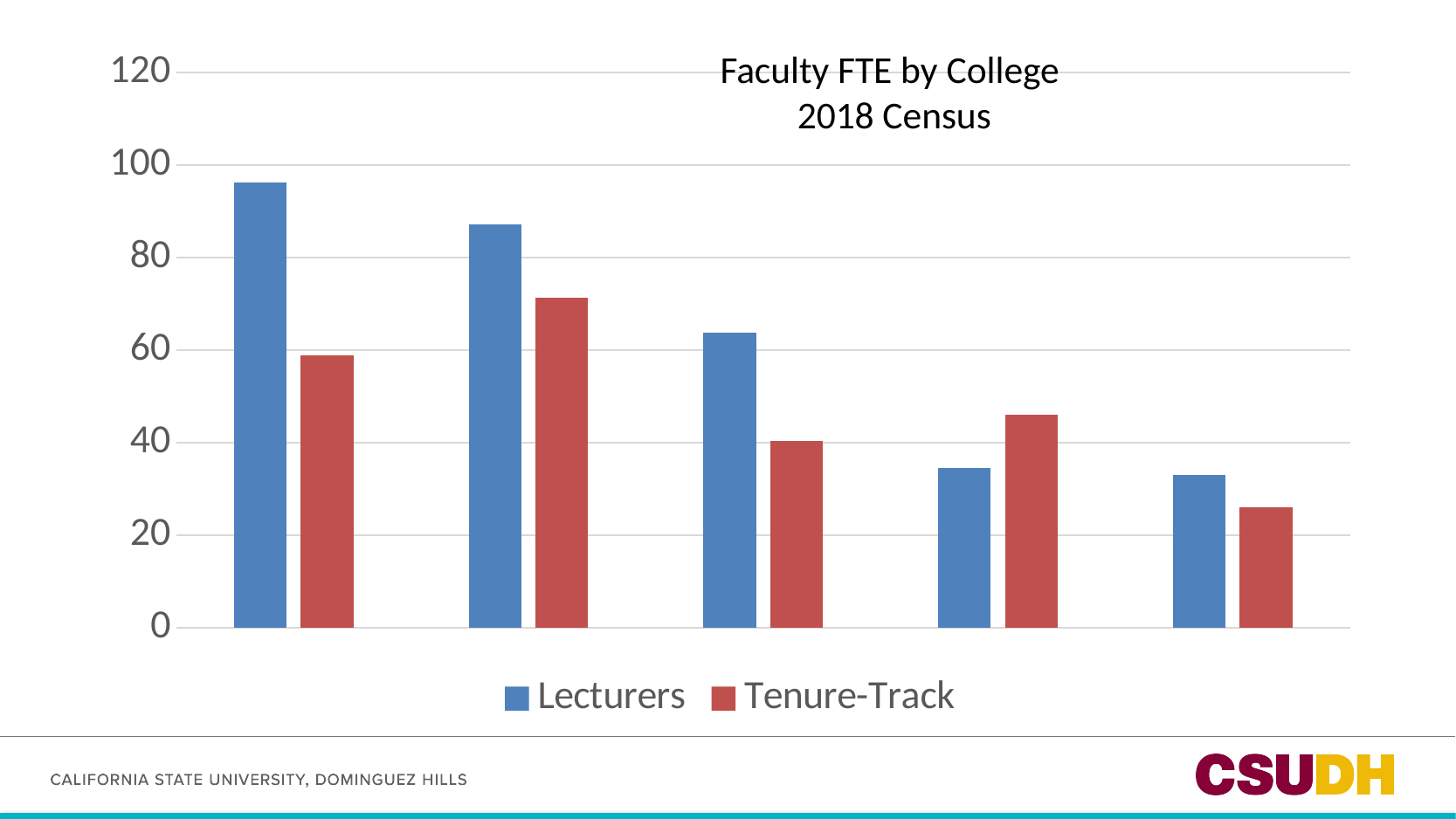
Is the Tenure-Track value for the second group from the left greater or less than 60? greater Is the Tenure-Track value for the rightmost group greater or less than 20? greater In the leftmost group, which series has the larger value, Lecturers or Tenure-Track? Lecturers In the fourth group from the left, which series has the larger value, Lecturers or Tenure-Track? Tenure-Track How many groups of bars are plotted along the x axis? 5 What kind of chart is shown on the slide? bar chart How many series does the legend list? 2 What is the title of the chart? Faculty FTE by College 2018 Census Which series is shown in red? Tenure-Track Is the Lecturers value for the fourth group from the left greater or less than 40? less Do the Lecturers values rise or fall from left to right along the x axis? fall